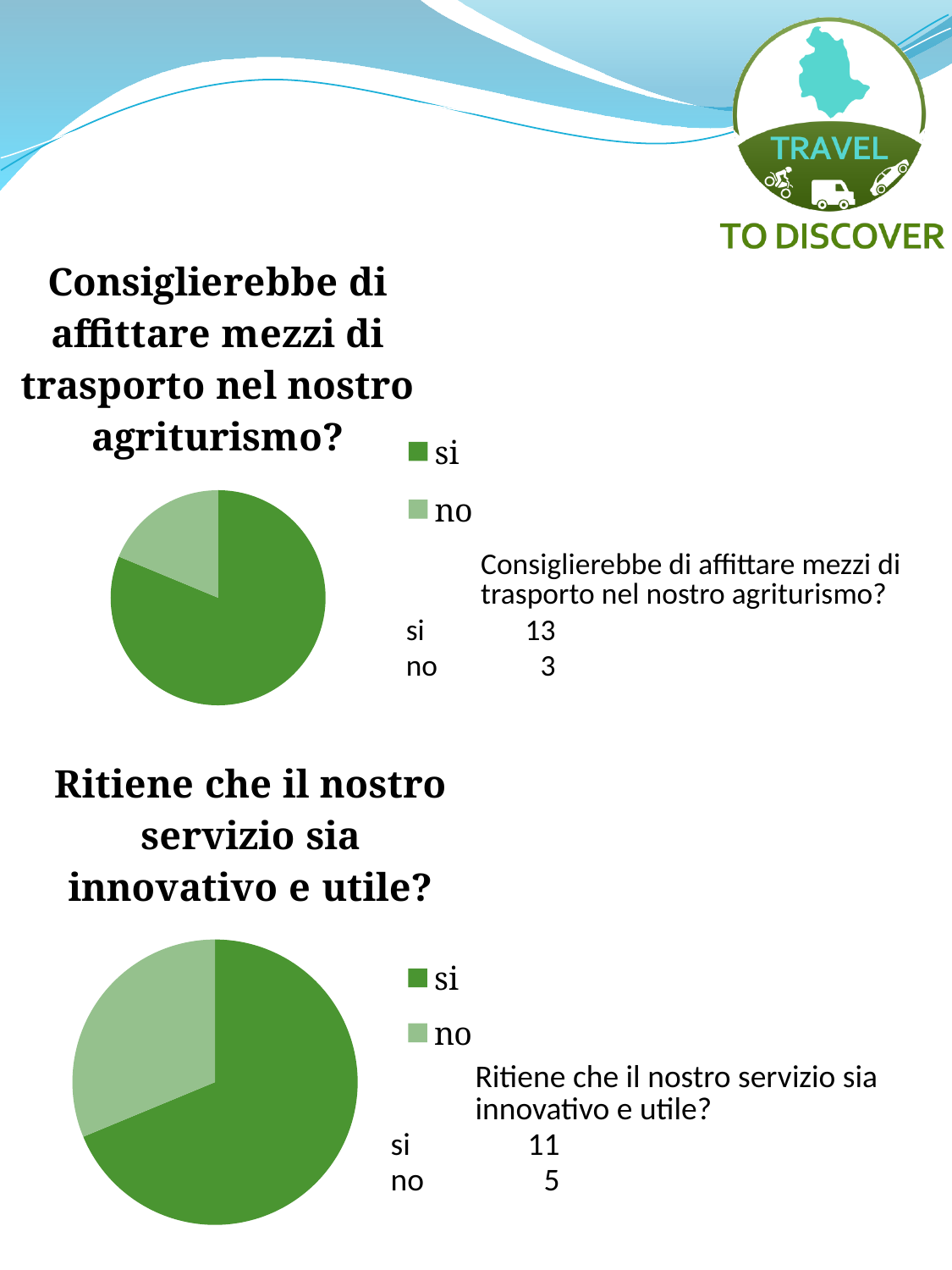
In the chart titled "Ritiene che il nostro servizio sia innovativo e utile?", what is the value for "si"? 11 In the chart titled "Ritiene che il nostro servizio sia innovativo e utile?", what share of the total does "no" represent? 31.25% In the chart titled "Consiglierebbe di affittare mezzi di trasporto nel nostro agriturismo?", which category has the largest slice? si What type of chart is the bottom chart on the slide? pie chart In the chart titled "Consiglierebbe di affittare mezzi di trasporto nel nostro agriturismo?", what is the value for "si"? 13 Is the "si" value larger in the top chart or in the bottom chart? top chart In the chart titled "Ritiene che il nostro servizio sia innovativo e utile?", what is the value for "no"? 5 In the chart titled "Ritiene che il nostro servizio sia innovativo e utile?", which category has the smallest slice? no In the chart titled "Consiglierebbe di affittare mezzi di trasporto nel nostro agriturismo?", what is the value for "no"? 3 How many entries does the legend of the top chart list? 2 In the chart titled "Consiglierebbe di affittare mezzi di trasporto nel nostro agriturismo?", what is the difference between the "si" and "no" values? 10 In the chart titled "Ritiene che il nostro servizio sia innovativo e utile?", what is the difference between the "si" and "no" values? 6